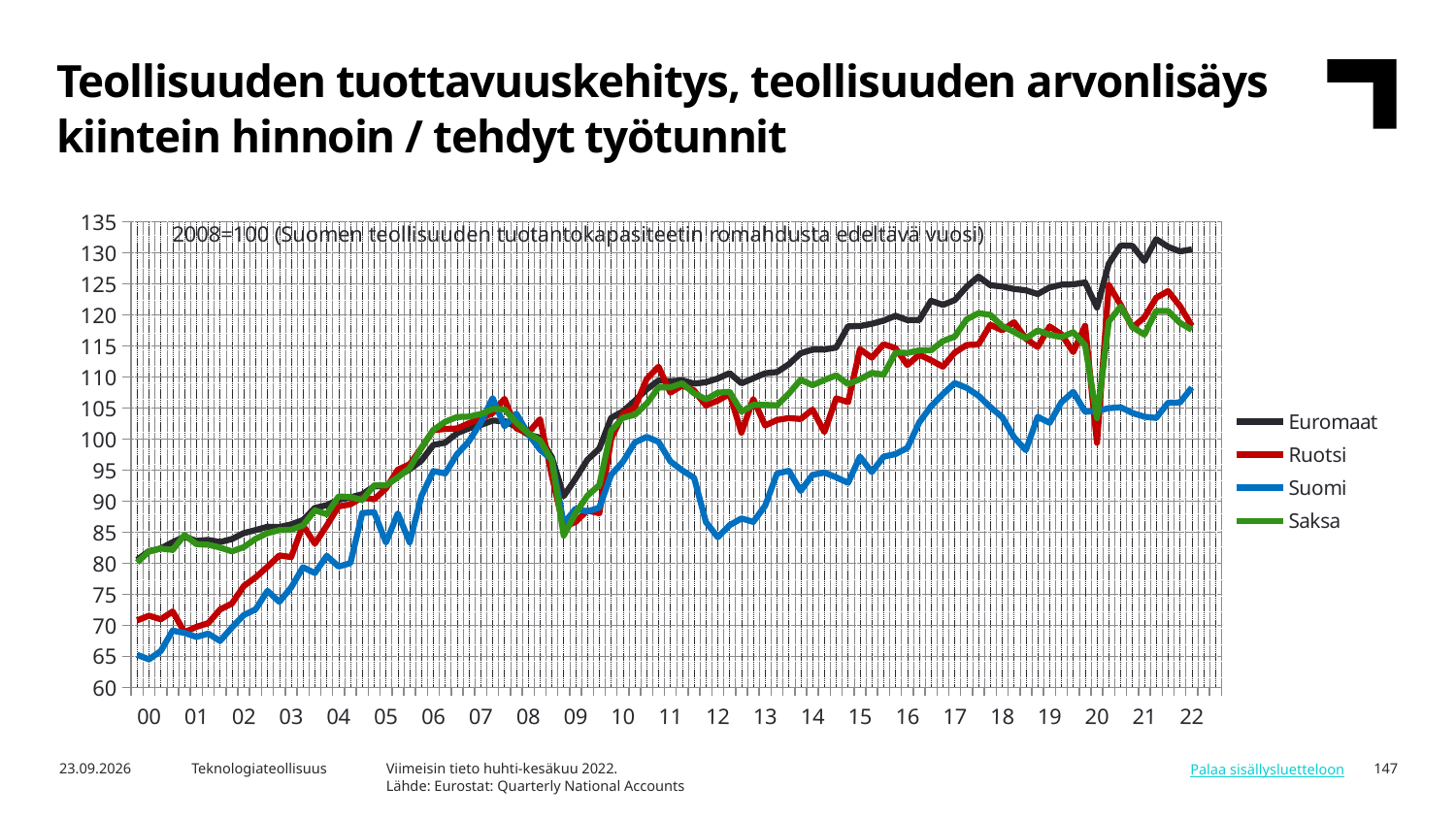
Which base year is set to 100 in the index, according to the note in the chart? 2008 Is the value for Suomi at 00 greater or less than 70? less At 00, which is higher: Saksa or Suomi? Saksa How many series does the legend list? 4 What kind of chart is shown on the slide? line chart Which series has the lowest value at the end of the chart (22)? Suomi Which series has the lowest value at the start of the chart (00)? Suomi Does the Euromaat series overall rise or fall from 00 to 22? rise Is the value for Euromaat at 22 greater or less than 125? greater Is the value for Suomi at 22 greater or less than 115? less Which series has the highest value at the end of the chart (22)? Euromaat Which series are listed in the legend? Euromaat, Ruotsi, Suomi, Saksa